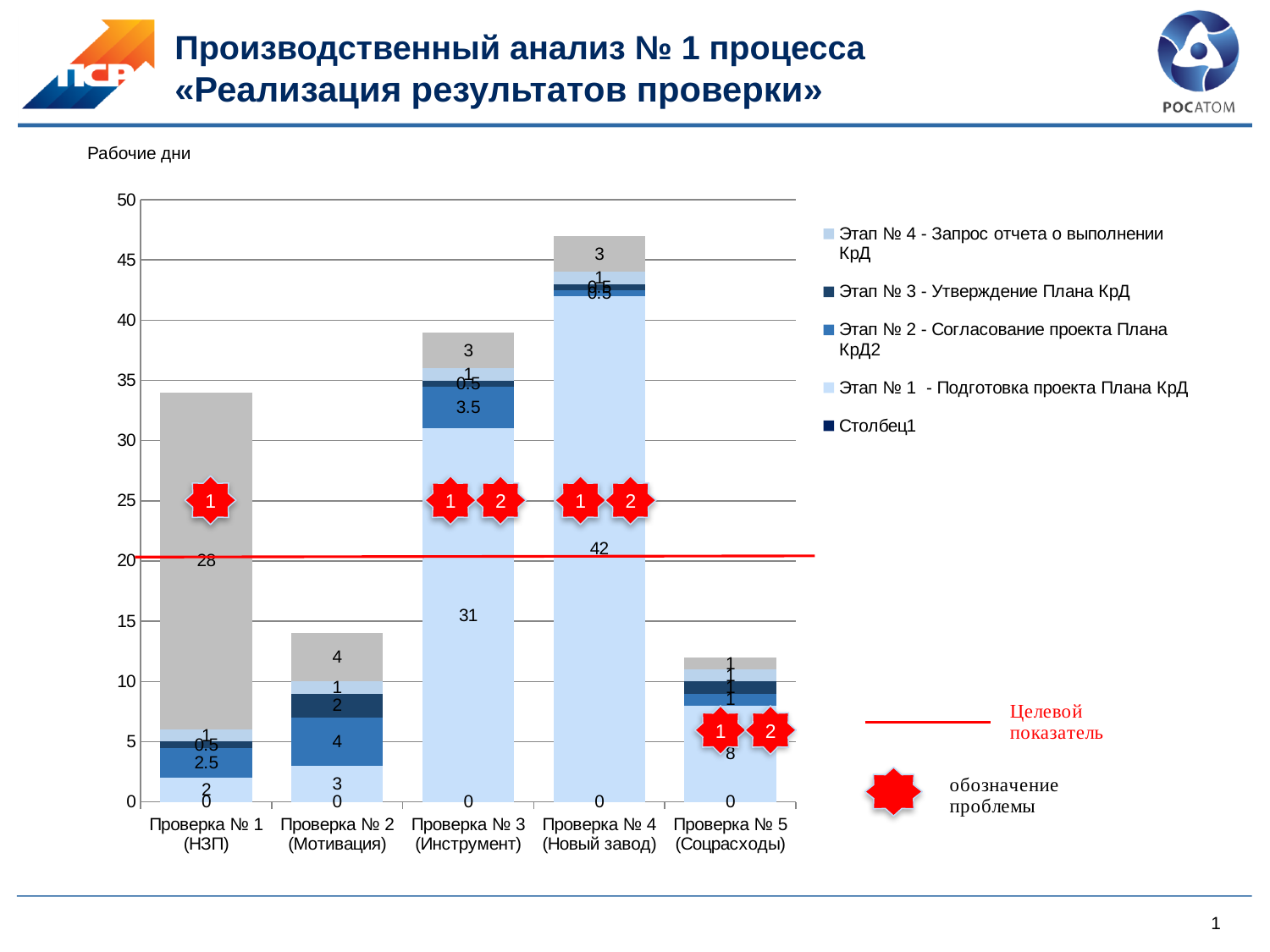
Which check has the tallest stacked bar overall? Проверка № 4 (Новый завод) Which check has the shortest stacked bar overall? Проверка № 5 (Соцрасходы) How many series does the legend list? 5 What is the difference between the Этап № 1 values for Проверка № 4 and Проверка № 3? 11 What is the value of Этап № 1 (Подготовка проекта Плана КрД) for Проверка № 4 (Новый завод)? 42 Which is larger: the Этап № 1 value for Проверка № 3 or for Проверка № 4? Проверка № 4 What is the value of Этап № 1 for Проверка № 5 (Соцрасходы)? 8 What kind of chart is shown on the slide? Stacked bar chart What is the value of Этап № 1 (Подготовка проекта Плана КрД) for Проверка № 3 (Инструмент)? 31 Is the total height of the bar for Проверка № 1 (НЗП) greater or less than 30? greater What is the value of Этап № 2 (Согласование проекта Плана КрД2) for Проверка № 2 (Мотивация)? 4 How many checks (Проверка) are shown along the x axis? 5